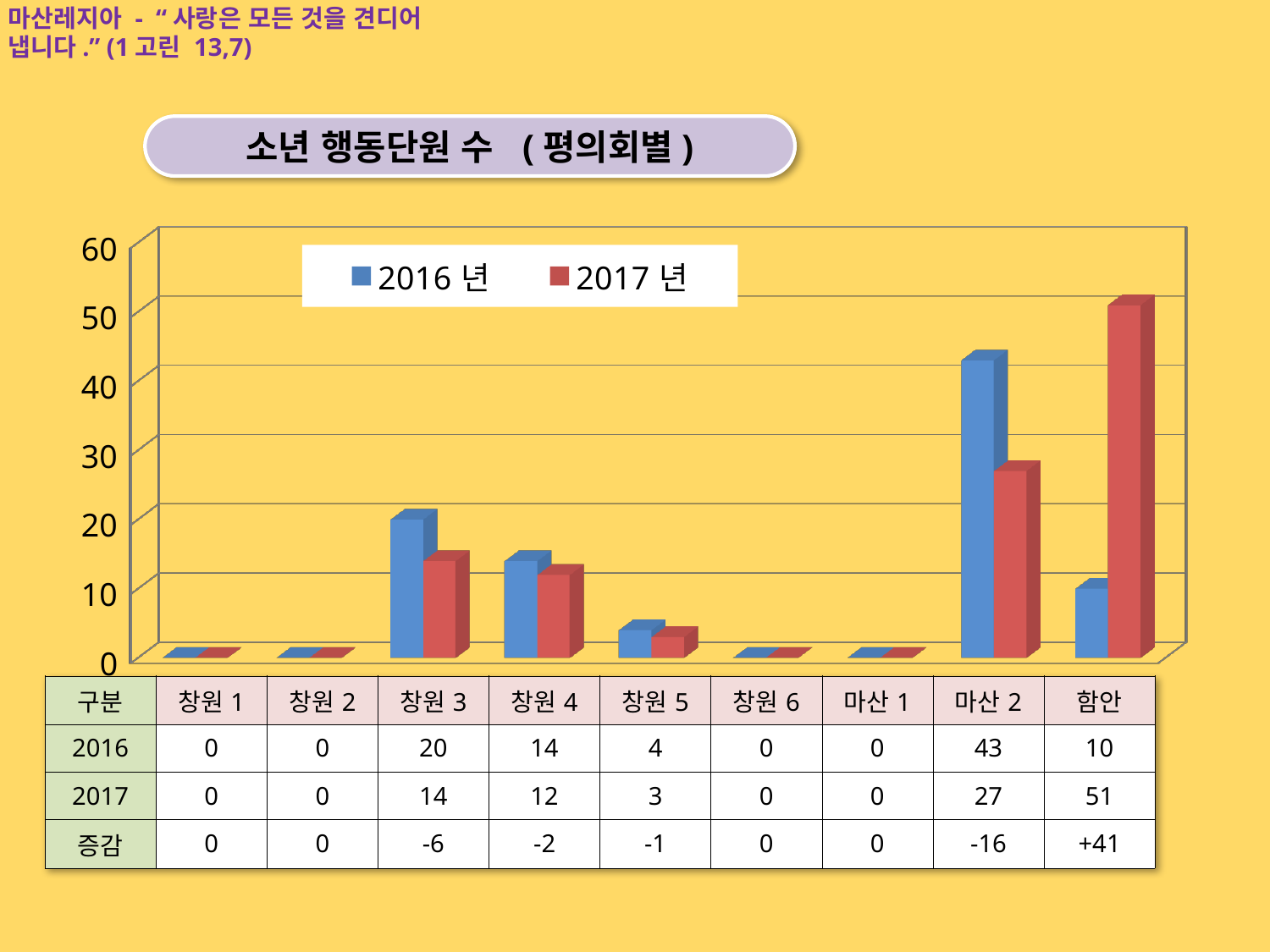
Is the 2017 년 value for 함안 greater or less than 50? greater How many series does the legend list? 2 How many categories are shown on the x axis of the chart? 9 What is the value for 함안 in the 2017 년 series? 51 Which category has the highest value in the 2017 년 series? 함안 What is the difference between the 2016 년 and 2017 년 values for 마산 2? 16 What is the value for 마산 2 in the 2016 년 series? 43 What type of chart is shown on the slide? bar chart What is the value for 창원 3 in the 2016 년 series? 20 What is the title of the chart? 소년 행동단원 수 (평의회별) Which category has the highest value in the 2016 년 series? 마산 2 Which is larger for 창원 4: the 2016 년 value or the 2017 년 value? 2016 년